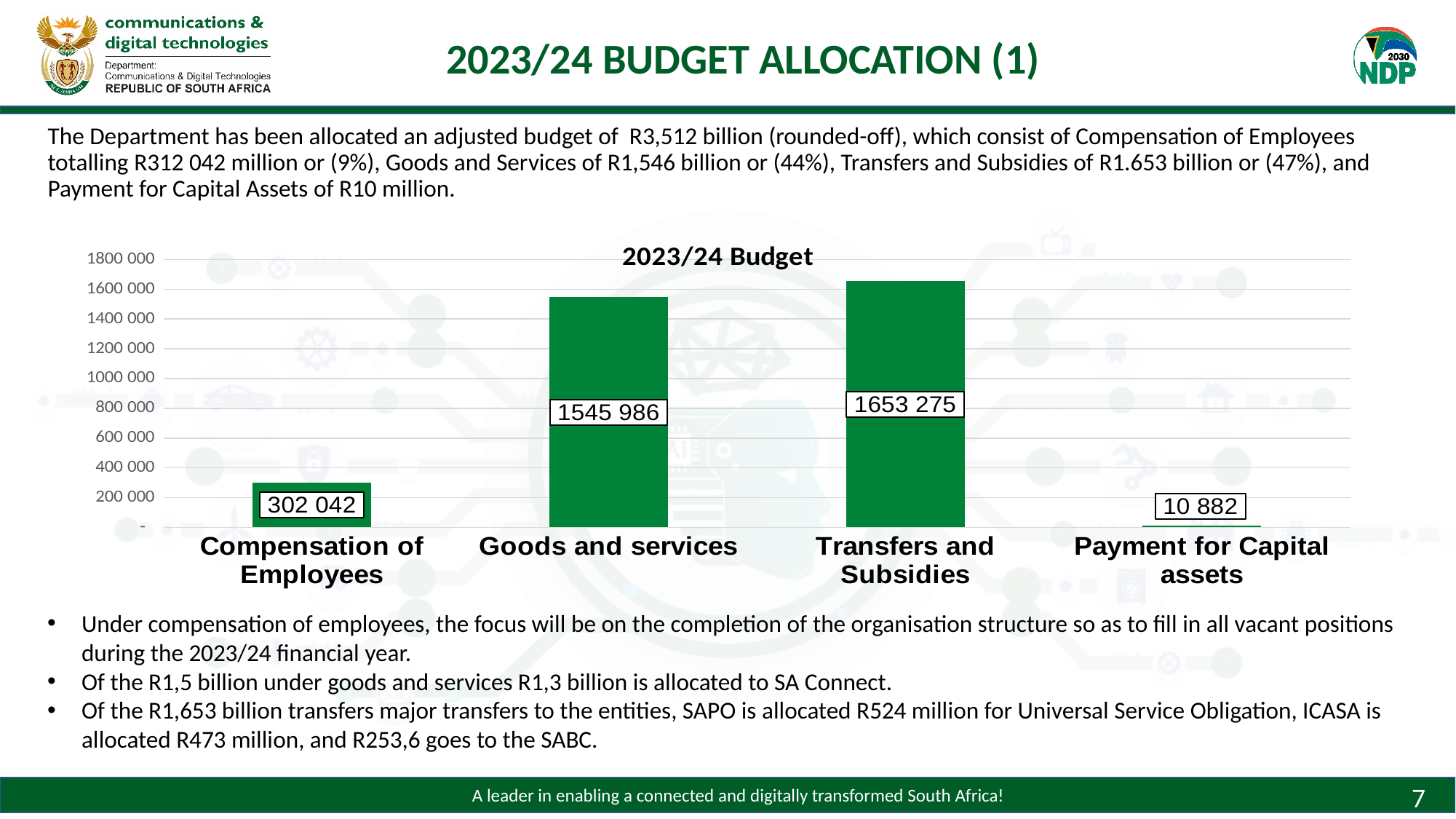
Which category has the highest value in the 2023/24 Budget chart? Transfers and Subsidies What is the difference between the values for Transfers and Subsidies and Goods and services in the 2023/24 Budget chart? 107 289 Which category has the lowest value in the 2023/24 Budget chart? Payment for Capital assets Is the value for Transfers and Subsidies in the 2023/24 Budget chart greater or less than 1600 000? greater What is the value for Goods and services in the 2023/24 Budget chart? 1545 986 How many categories are shown in the 2023/24 Budget chart? 4 What is the value for Payment for Capital assets in the 2023/24 Budget chart? 10 882 What is the value for Compensation of Employees in the 2023/24 Budget chart? 302 042 What kind of chart is the 2023/24 Budget chart? bar chart What is the value for Transfers and Subsidies in the 2023/24 Budget chart? 1653 275 What is the difference between the values for Compensation of Employees and Payment for Capital assets in the 2023/24 Budget chart? 291 160 In the 2023/24 Budget chart, which is larger: Goods and services or Compensation of Employees? Goods and services